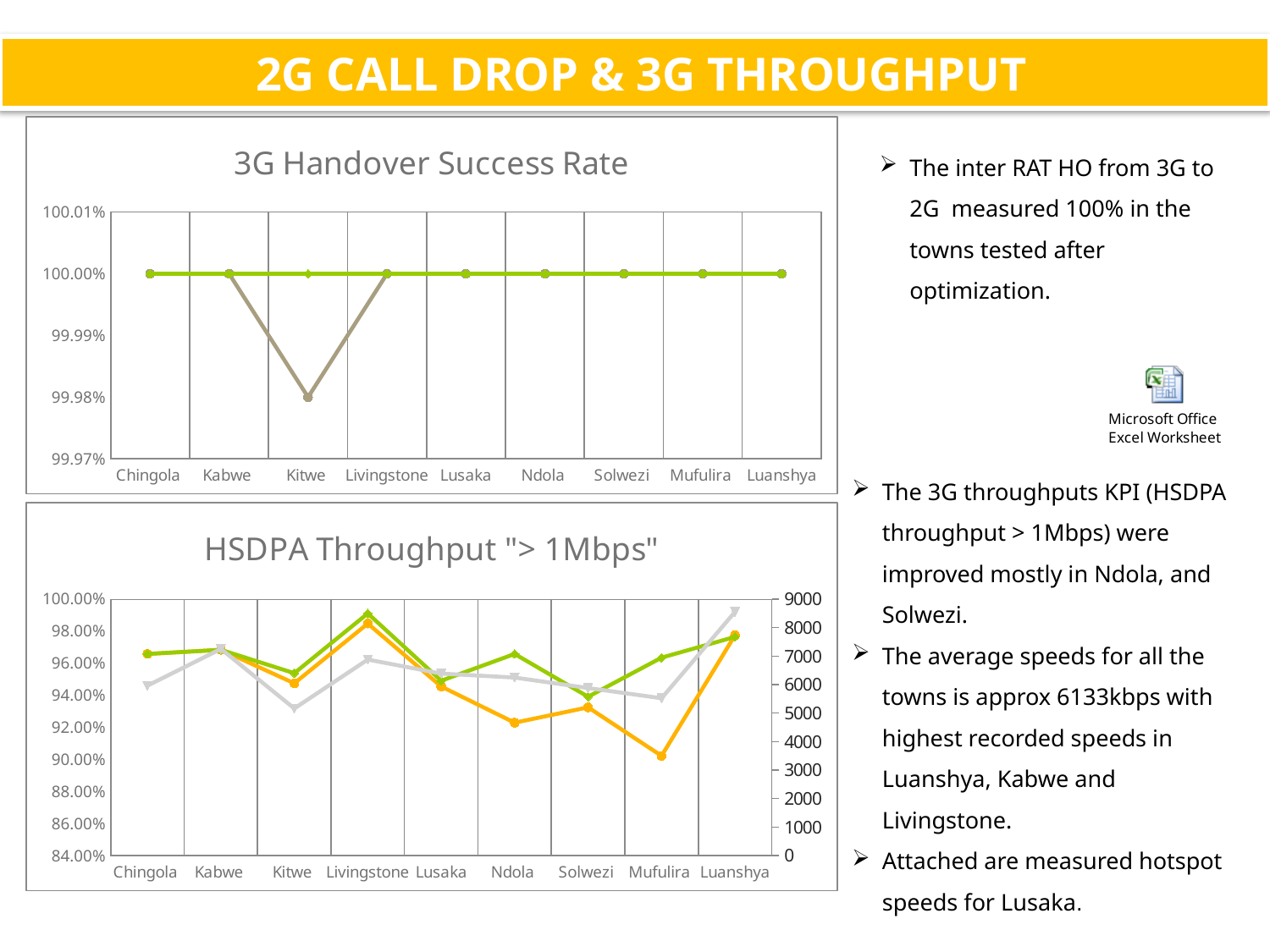
In the "HSDPA Throughput "> 1Mbps"" chart, which is higher at Ndola: the green line or the orange line? the green line In the "3G Handover Success Rate" chart, at which town does the tan line dip below 100.00%? Kitwe In the "HSDPA Throughput "> 1Mbps"" chart, is the green line's value at Livingstone greater or less than 98.00%? greater In the "HSDPA Throughput "> 1Mbps"" chart, is the orange line's value at Mufulira greater or less than 92.00%? less What is the maximum value shown on the right-hand axis of the "HSDPA Throughput "> 1Mbps"" chart? 9000 What type of chart is the "3G Handover Success Rate" chart? line chart How many towns are shown on the x axis of the "3G Handover Success Rate" chart? 9 How many towns are listed on the x axis of the "HSDPA Throughput "> 1Mbps"" chart? 9 In the "3G Handover Success Rate" chart, what value does the tan line reach at Kitwe? 99.98% In the "3G Handover Success Rate" chart, what value does the green line show at Lusaka? 100.00% What is the title of the lower chart on the slide? HSDPA Throughput "> 1Mbps" In the "HSDPA Throughput "> 1Mbps"" chart, at which town does the orange line reach its lowest point? Mufulira